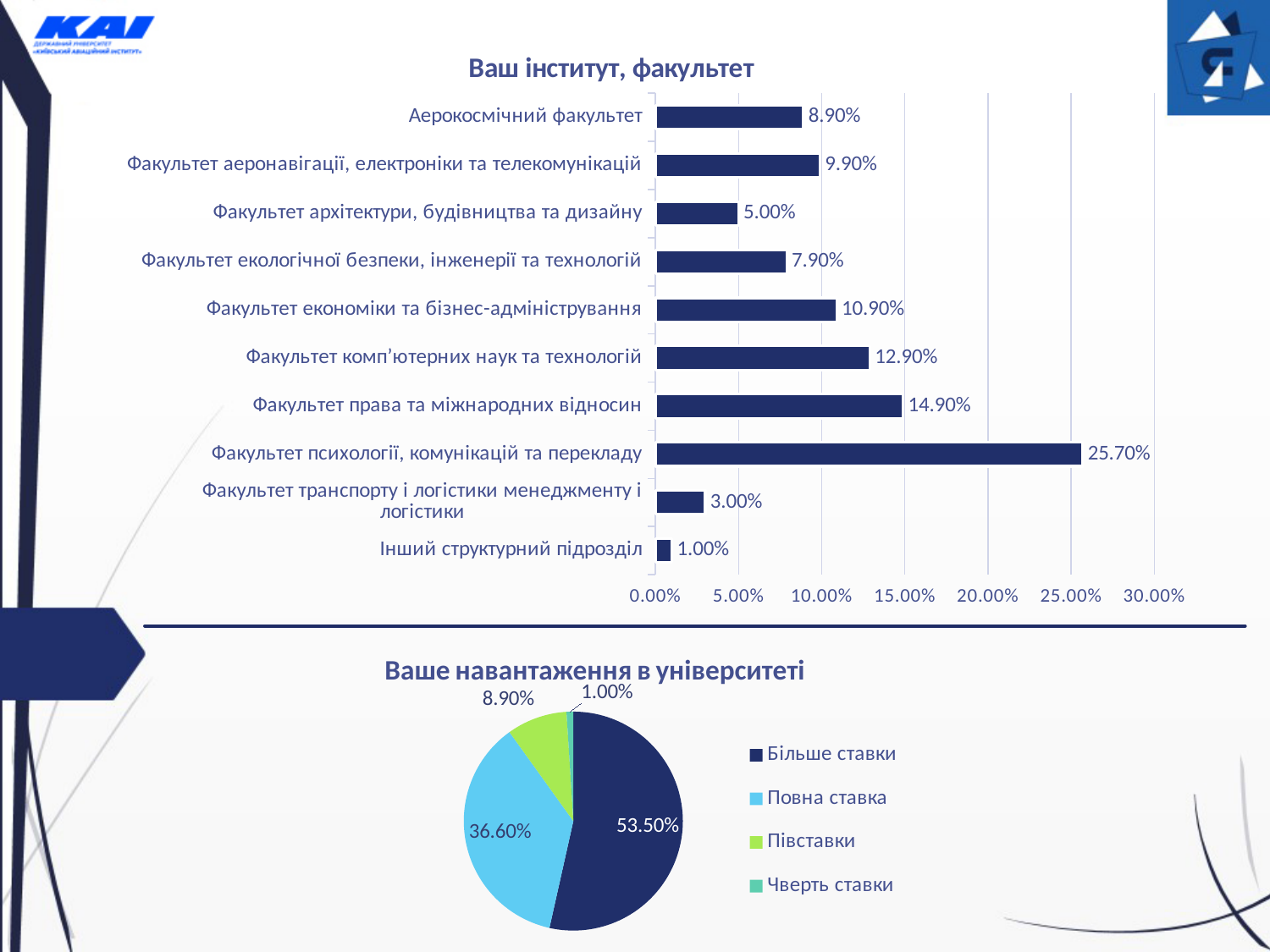
In the pie chart 'Ваше навантаження в університеті', how many entries does the legend list? 4 In the pie chart 'Ваше навантаження в університеті', which category has the largest share? Більше ставки In the chart 'Ваш інститут, факультет', what is the difference between Факультет права та міжнародних відносин and Факультет економіки та бізнес-адміністрування? 4.00% In the pie chart 'Ваше навантаження в університеті', what is the share for Повна ставка? 36.60% What kind of chart is 'Ваш інститут, факультет'? Bar chart What kind of chart is 'Ваше навантаження в університеті'? Pie chart In the chart 'Ваш інститут, факультет', which is larger: Аерокосмічний факультет or Факультет аеронавігації, електроніки та телекомунікацій? Факультет аеронавігації, електроніки та телекомунікацій In the chart 'Ваш інститут, факультет', how many categories are shown? 10 In the chart 'Ваш інститут, факультет', which category has the highest value? Факультет психології, комунікацій та перекладу In the chart 'Ваш інститут, факультет', what is the value for Факультет психології, комунікацій та перекладу? 25.70% In the chart 'Ваш інститут, факультет', what is the value for Факультет комп’ютерних наук та технологій? 12.90% In the chart 'Ваш інститут, факультет', which category has the lowest value? Інший структурний підрозділ